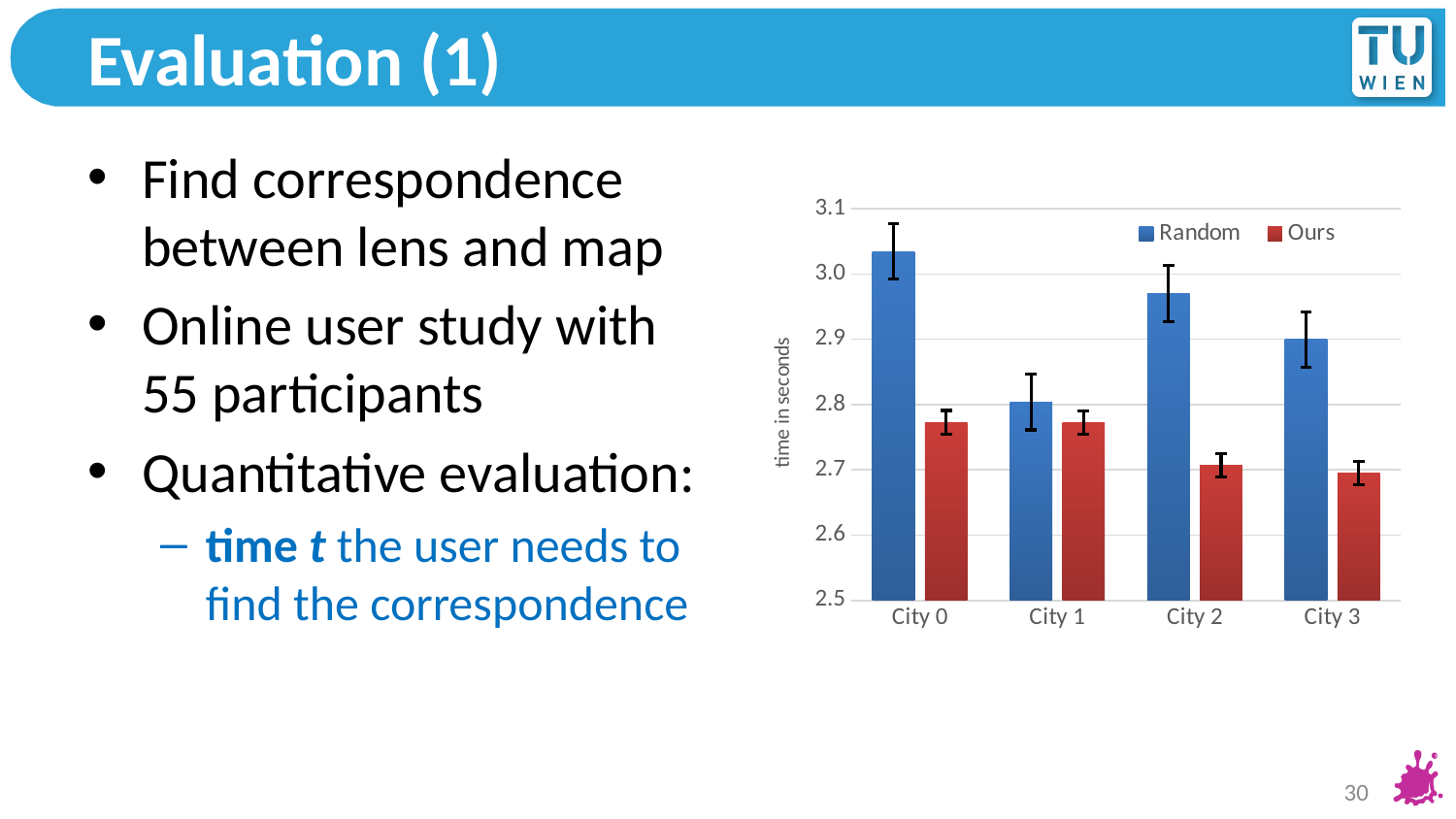
For which city is the Random series highest? City 0 What kind of chart is shown on the slide? bar chart What is the label of the chart's y axis? time in seconds Is the Random value for City 3 greater or less than 3.0? less Is the Ours value for City 0 greater or less than 2.8? less For City 0, which series has the larger value, Random or Ours? Random How many series does the chart's legend list? 2 For which city is the Random series lowest? City 1 Is the Random value for City 0 greater or less than 3.0? greater Which series are listed in the chart's legend? Random and Ours For City 2, which series has the larger value, Random or Ours? Random How many cities are shown on the x axis of the chart? 4